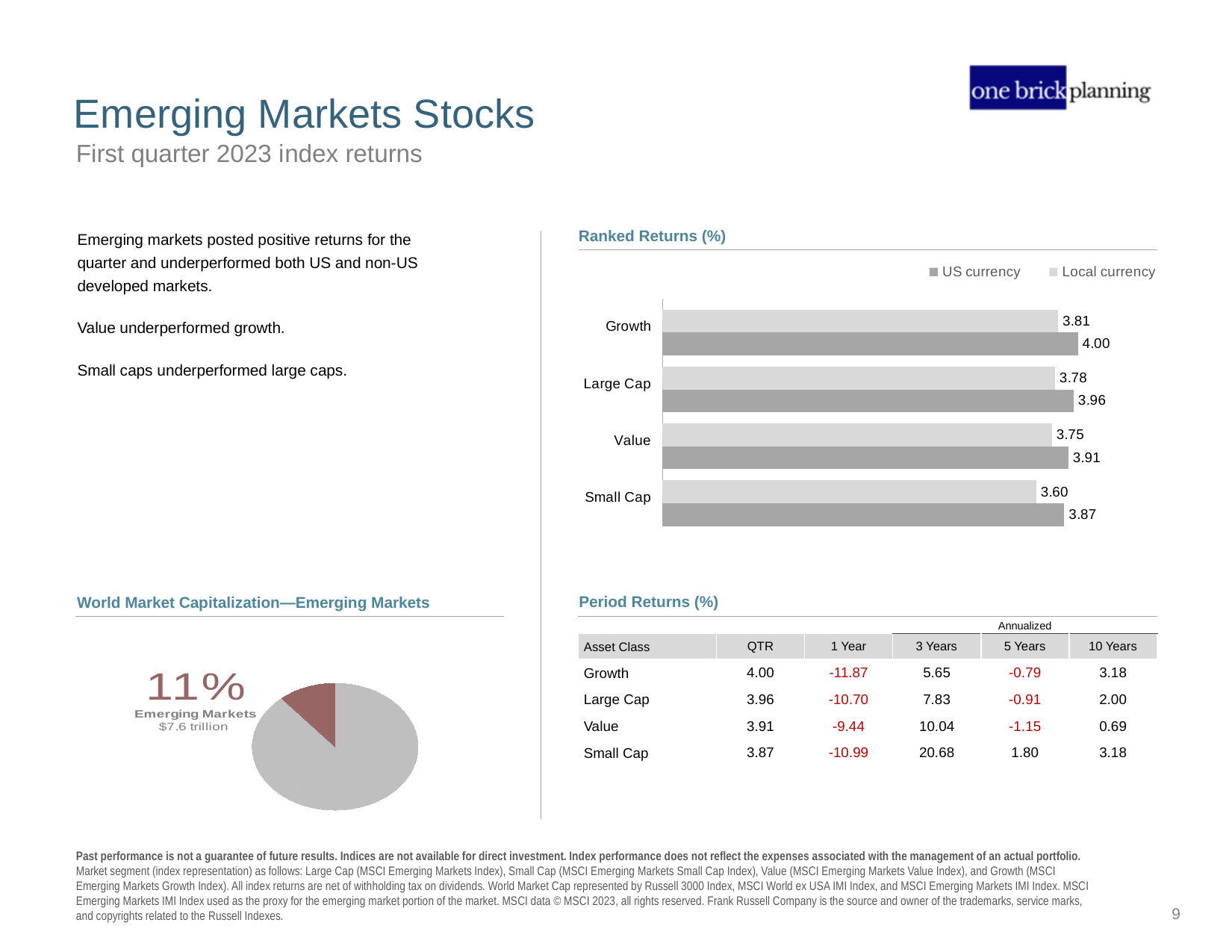
In the Ranked Returns (%) chart, which category has the lowest Local currency return? Small Cap What kind of chart is the Ranked Returns (%) chart? Bar chart In the Ranked Returns (%) chart, which category has the highest US currency return? Growth In the World Market Capitalization—Emerging Markets pie chart, what share of world market capitalization do Emerging Markets represent? 11% In the Ranked Returns (%) chart, what is the difference between the US currency and Local currency returns for Value? 0.16 In the Ranked Returns (%) chart, what is the US currency return for Growth? 4.00 How many categories are shown in the Ranked Returns (%) chart? 4 In the World Market Capitalization—Emerging Markets pie chart, what dollar value is shown for Emerging Markets? $7.6 trillion In the Ranked Returns (%) chart, what is the Local currency return for Large Cap? 3.78 In the Ranked Returns (%) chart, which is larger for Small Cap: the US currency return or the Local currency return? US currency How many series does the legend of the Ranked Returns (%) chart list? 2 In the Ranked Returns (%) chart, what is the Local currency return for Small Cap? 3.60